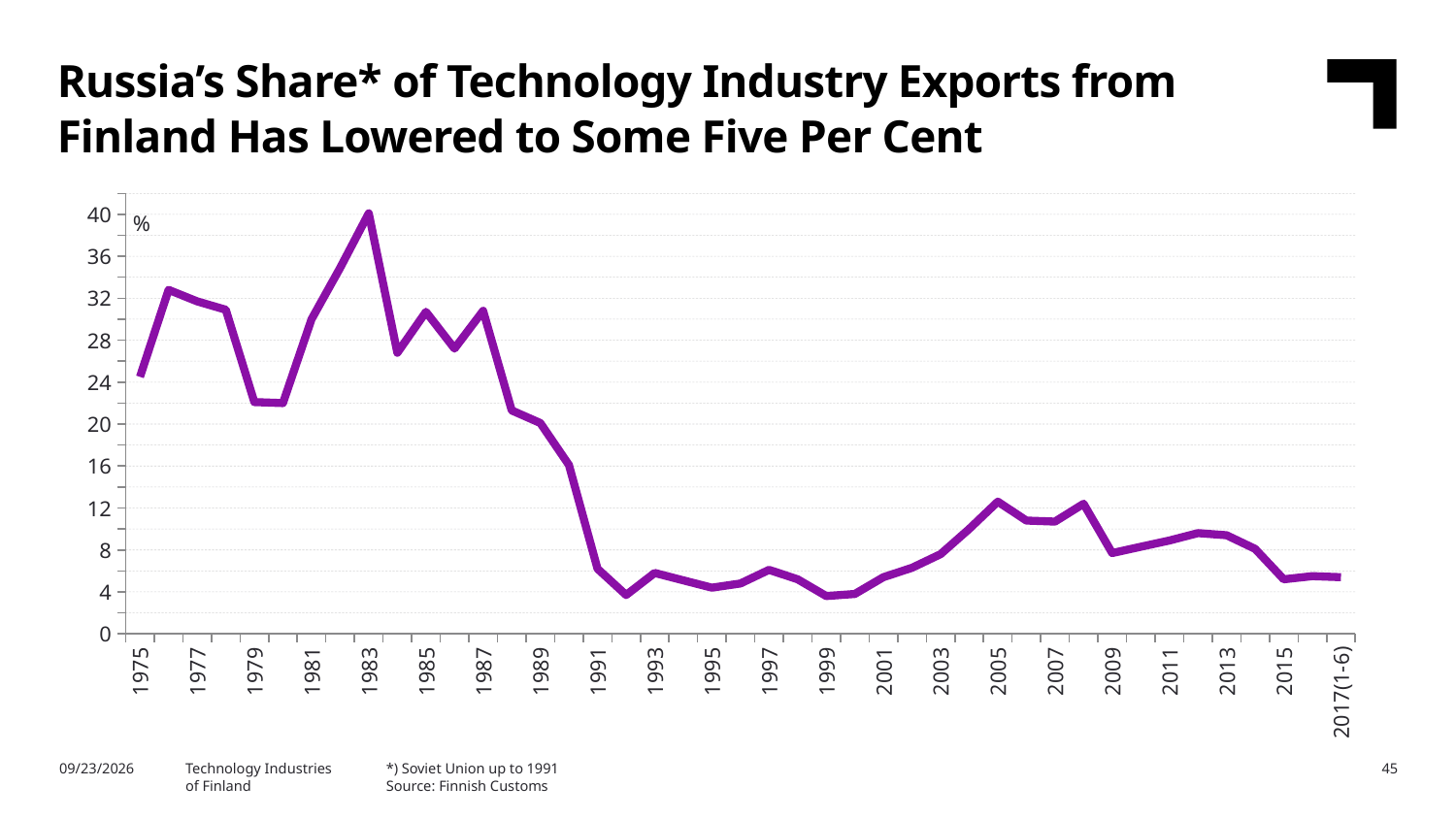
Is the value for 2005 greater or less than 8? greater In which year does Russia's share of technology industry exports from Finland reach its highest value? 1983 What kind of chart is shown on the slide? line chart Is the value for 2017(1-6) greater or less than 8? less What unit is shown on the vertical axis of the chart? % Which year has the larger value, 1983 or 1975? 1983 Is the value for 1975 greater or less than 20? greater According to the footnote, what does the asterisk in the title refer to? Soviet Union up to 1991 Which year has the larger value, 2005 or 2015? 2005 Does the share rise or fall between 1983 and 1992? fall